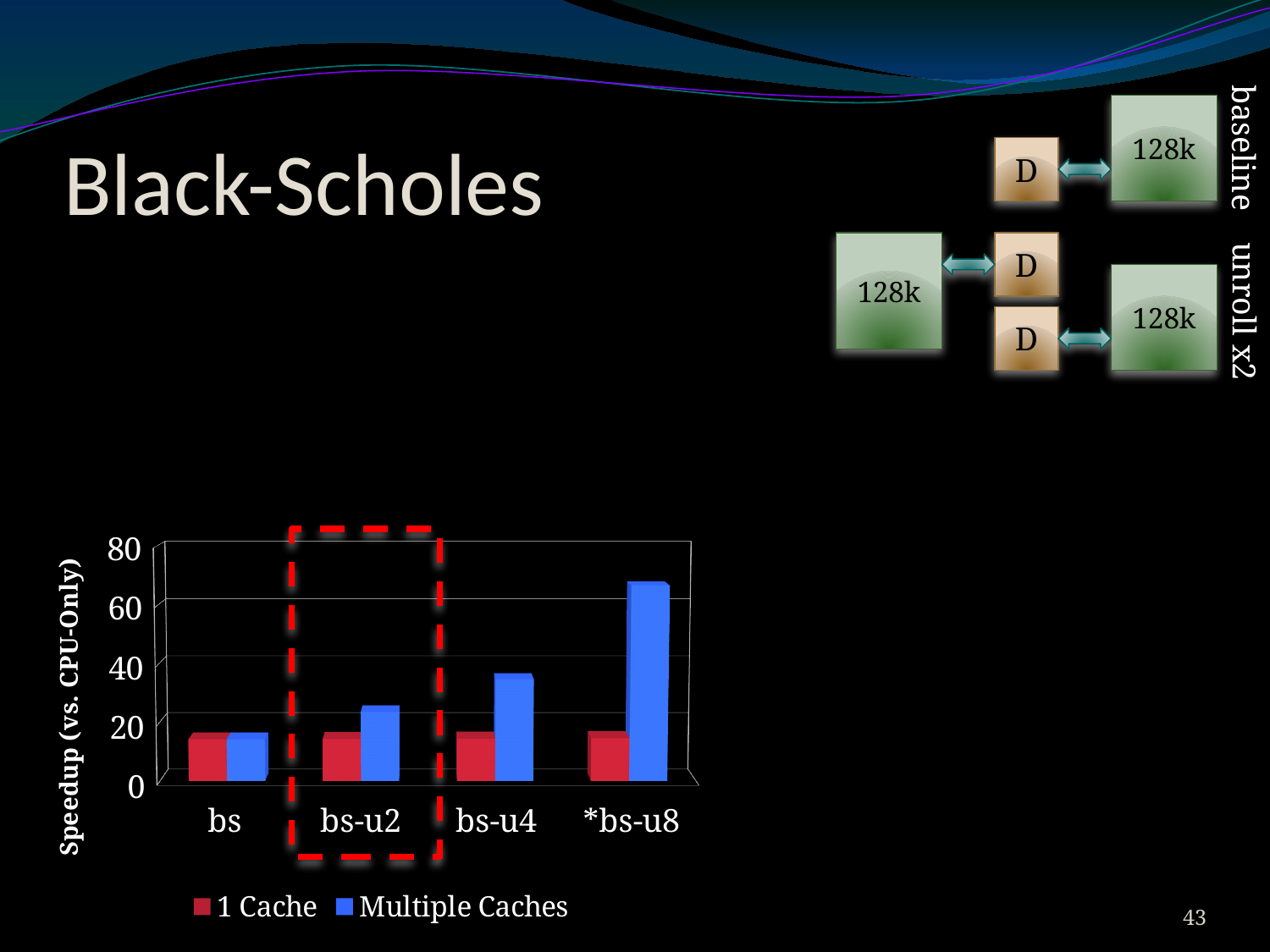
How many categories are shown on the x axis of the chart? 4 Is the Multiple Caches value for *bs-u8 greater or less than 60? greater Is the Multiple Caches value for bs-u2 greater or less than 20? greater Is the 1 Cache value for bs greater or less than 20? less Do the Multiple Caches values rise or fall from bs to *bs-u8? rise What kind of chart is shown on the slide? bar chart Which category on the chart is enclosed by the red dashed box? bs-u2 What is the label of the chart's vertical axis? Speedup (vs. CPU-Only) For bs-u4, which is larger: the 1 Cache value or the Multiple Caches value? Multiple Caches Which category has the highest Multiple Caches speedup? *bs-u8 How many series does the chart's legend list? 2